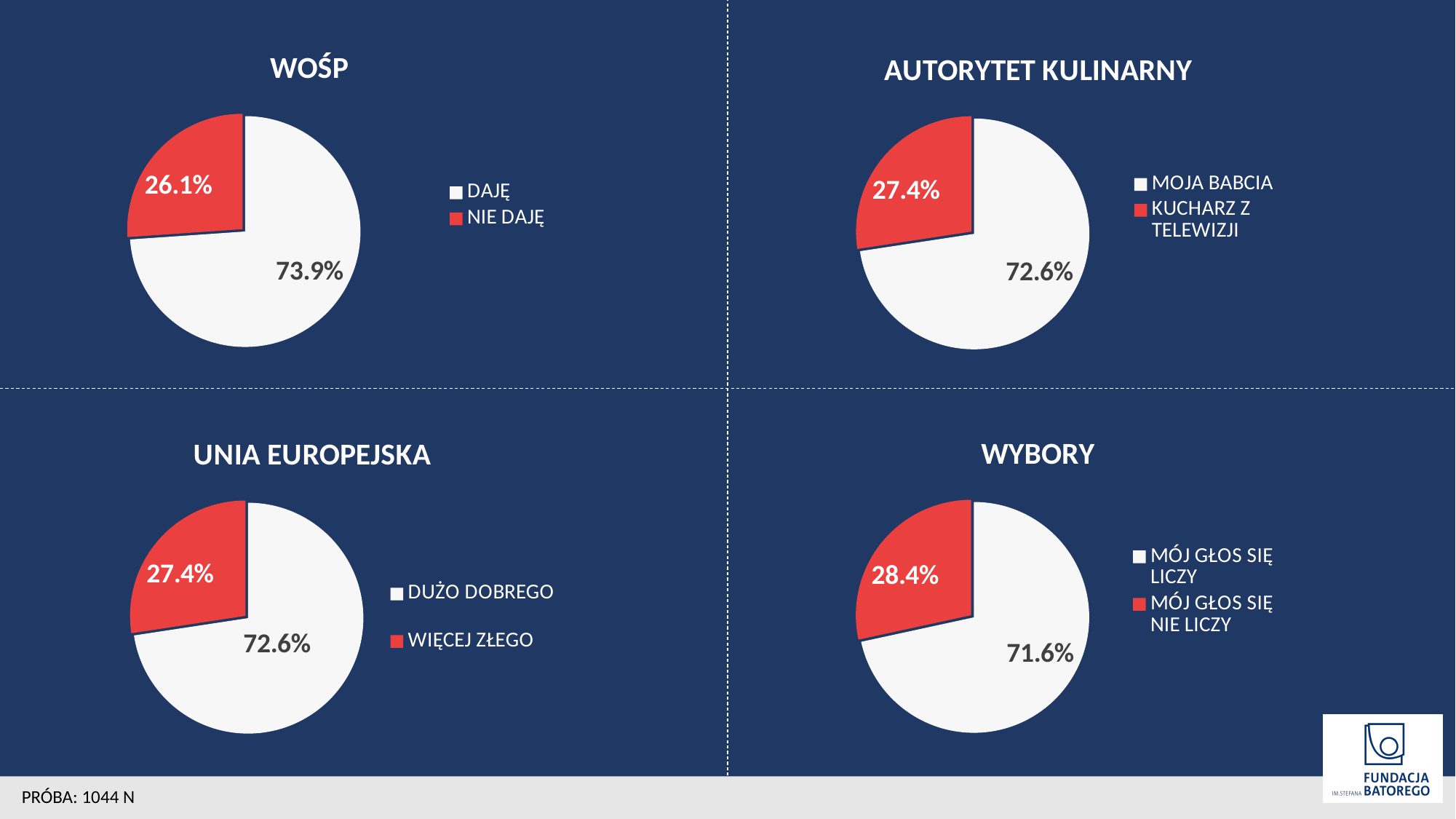
In the WOŚP chart, what share of respondents answered NIE DAJĘ? 26.1% In the AUTORYTET KULINARNY chart, what share chose MOJA BABCIA? 72.6% In the WYBORY chart, what share answered MÓJ GŁOS SIĘ NIE LICZY? 28.4% How many slices does the WYBORY pie chart have? 2 In the UNIA EUROPEJSKA chart, which category is the largest? DUŻO DOBREGO In the WYBORY chart, which slice is larger: MÓJ GŁOS SIĘ LICZY or MÓJ GŁOS SIĘ NIE LICZY? MÓJ GŁOS SIĘ LICZY In the AUTORYTET KULINARNY chart, what share chose KUCHARZ Z TELEWIZJI? 27.4% In the UNIA EUROPEJSKA chart, what share answered WIĘCEJ ZŁEGO? 27.4% In the AUTORYTET KULINARNY chart, what colour is the KUCHARZ Z TELEWIZJI slice? Red In the WOŚP chart, what is the difference in percentage points between DAJĘ and NIE DAJĘ? 47.8 What type of chart is used in the UNIA EUROPEJSKA panel? Pie chart In the WOŚP chart, what share of respondents answered DAJĘ? 73.9%